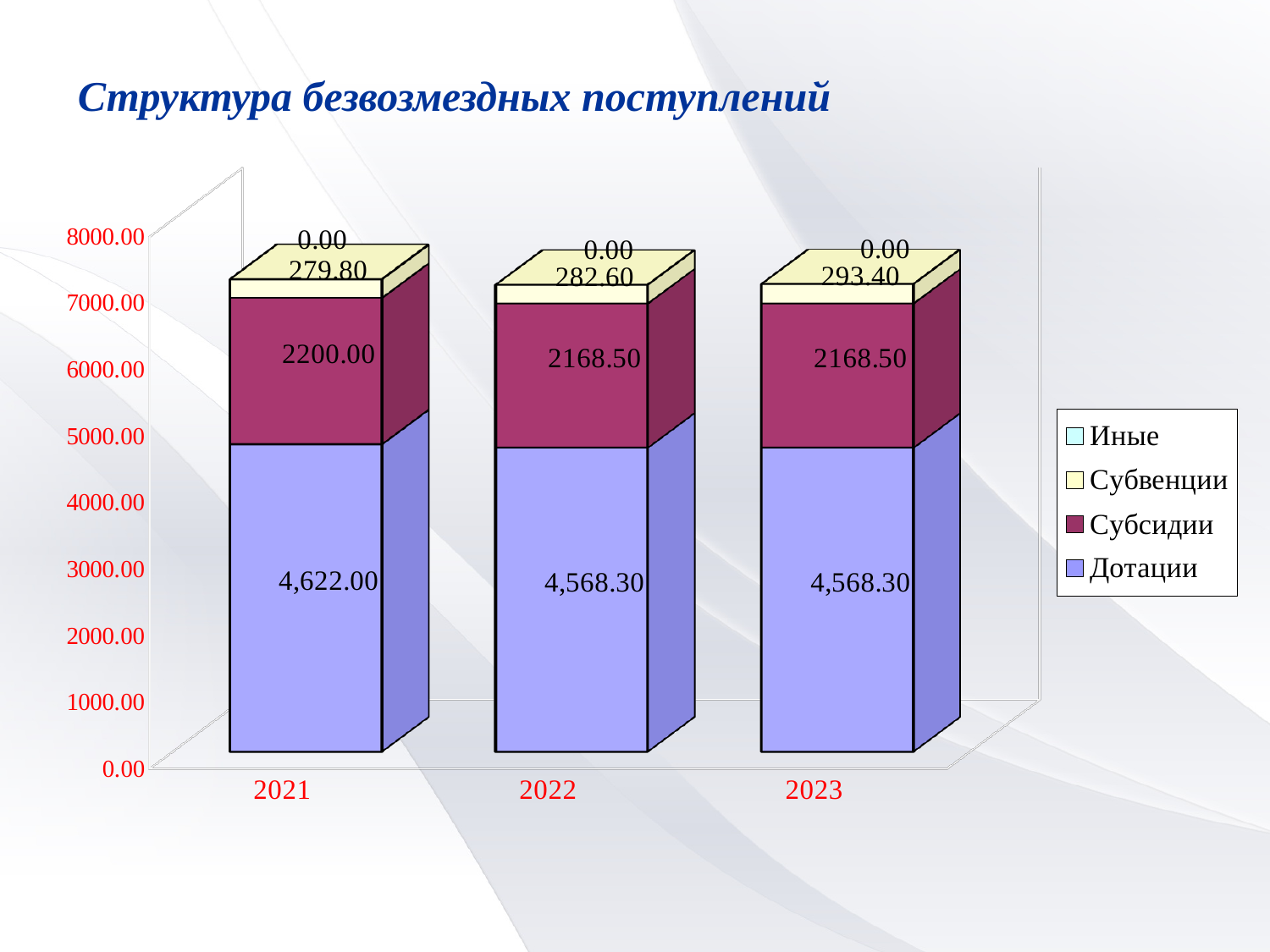
How many series does the legend list? 4 What is the value of Субсидии for 2022? 2168.50 How many years are shown on the x axis? 3 What type of chart is shown on the slide? Stacked bar chart Which year has the highest value for Субвенции? 2023 What is the value of Субвенции for 2023? 293.40 Which is larger, the Субсидии value for 2021 or for 2023? 2021 What is the value of Дотации for 2021? 4,622.00 What is the difference between the Дотации values for 2021 and 2022? 53.70 What is the value of Иные for 2021? 0.00 What is the total of the stacked bar for 2021? 7101.80 Which year has the lowest value for Субвенции? 2021